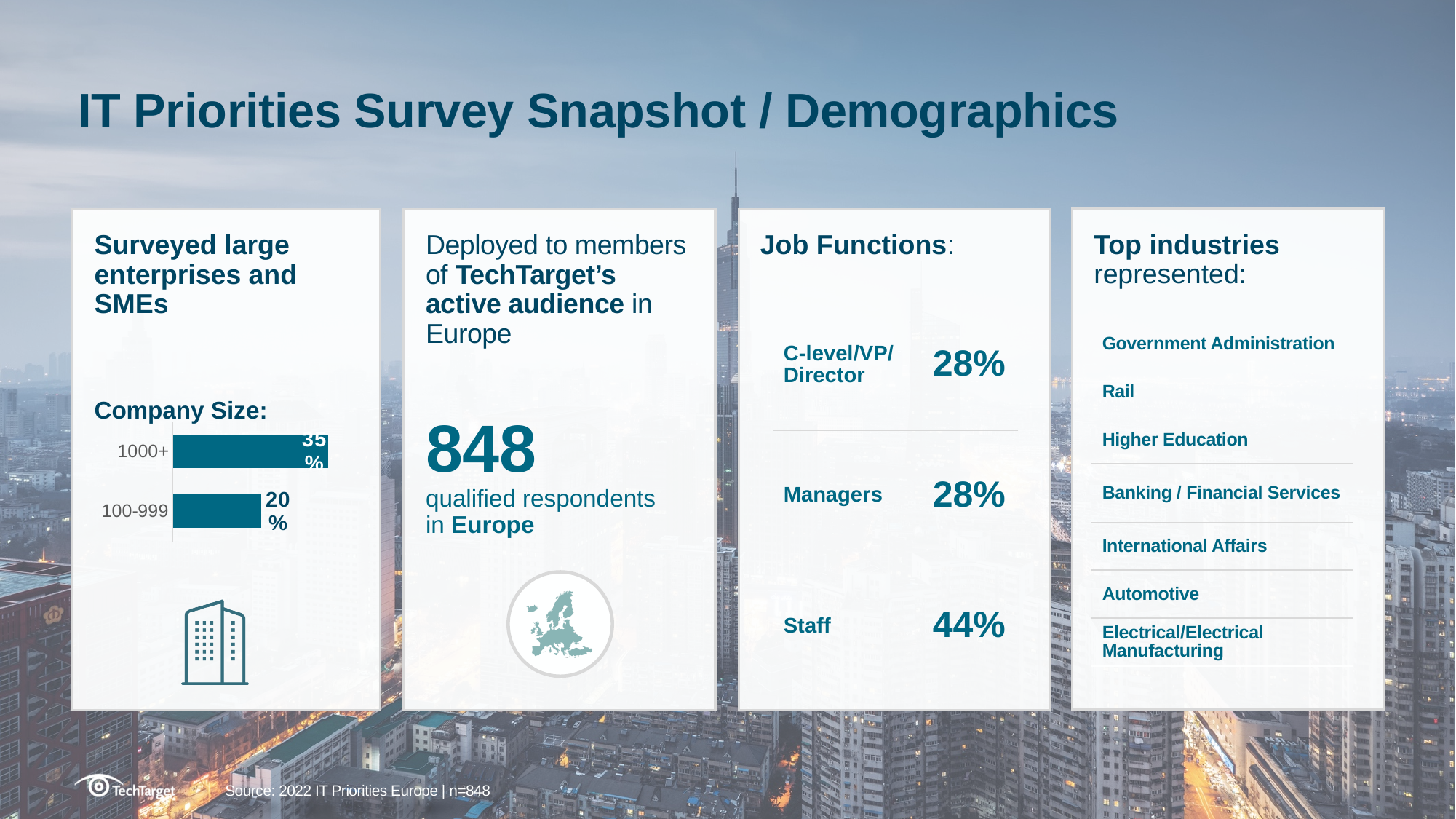
In the Company Size chart, which company size category has the highest value? 1000+ In the Company Size chart, what is the value for 1000+? 35% Are the bars in the Company Size chart horizontal or vertical? Horizontal What is the title of the chart in the left panel of the slide? Company Size: In the Company Size chart, which is larger: the value for 1000+ or the value for 100-999? 1000+ What kind of chart is the Company Size chart? Bar chart In the Company Size chart, what is the difference between the values for 1000+ and 100-999? 15% In the Company Size chart, what is the value for 100-999? 20% In the Company Size chart, which company size category has the lowest value? 100-999 How many categories are shown in the Company Size chart? 2